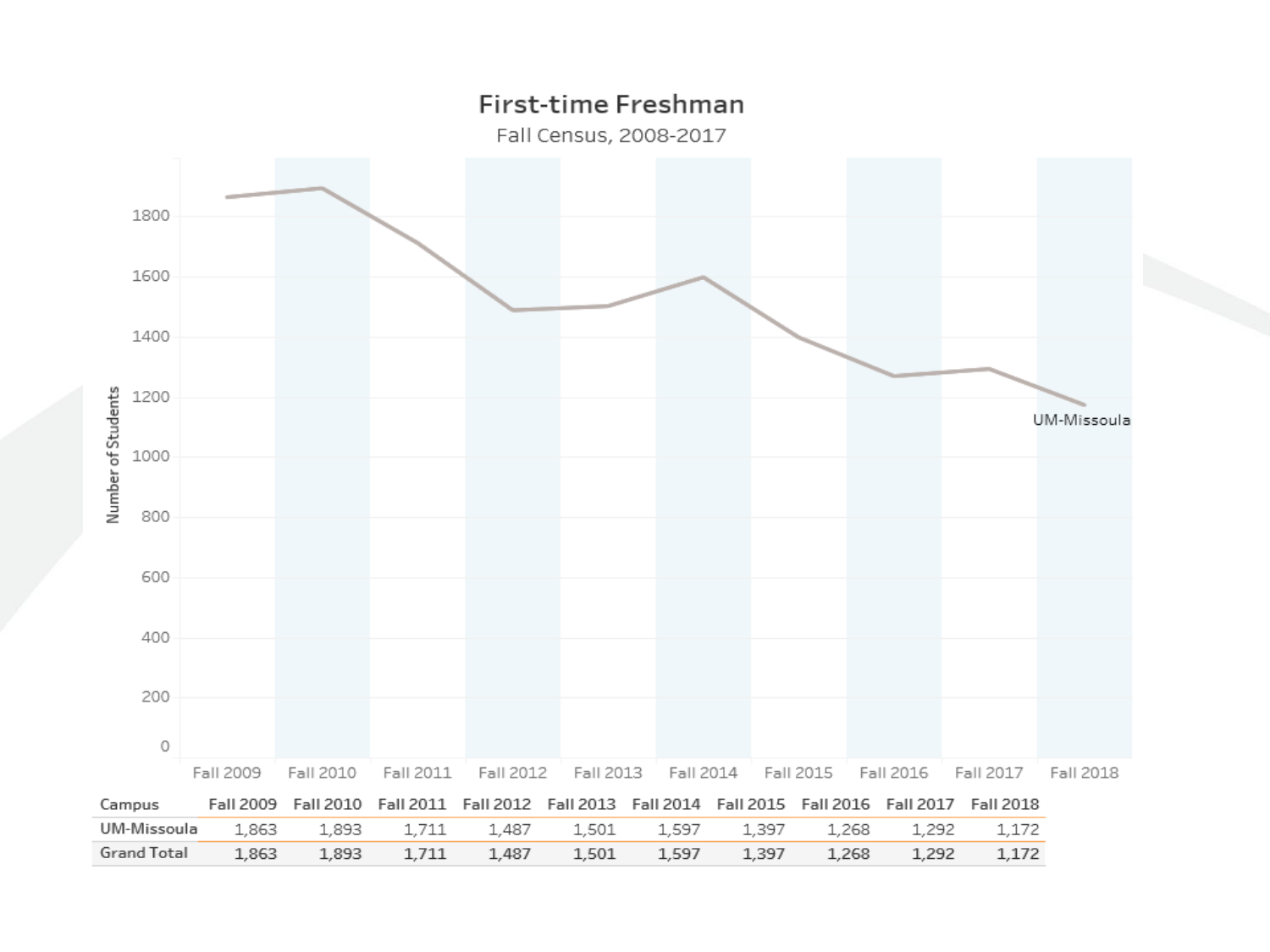
What kind of chart is shown on the slide? line chart How many fall terms are plotted on the x axis? 10 Which fall term has the lowest number of first-time freshmen? Fall 2018 What is the number of first-time freshmen at UM-Missoula in Fall 2018? 1,172 What is the title of the chart? First-time Freshman Is the value for Fall 2011 greater or less than 1600? greater Overall, do the values rise or fall from Fall 2009 to Fall 2018? fall What is the label on the y axis? Number of Students Which is larger, the number of first-time freshmen in Fall 2014 or in Fall 2015? Fall 2014 What is the number of first-time freshmen at UM-Missoula in Fall 2012? 1,487 Which fall term has the highest number of first-time freshmen? Fall 2010 What is the difference in first-time freshmen between Fall 2009 and Fall 2018? 691